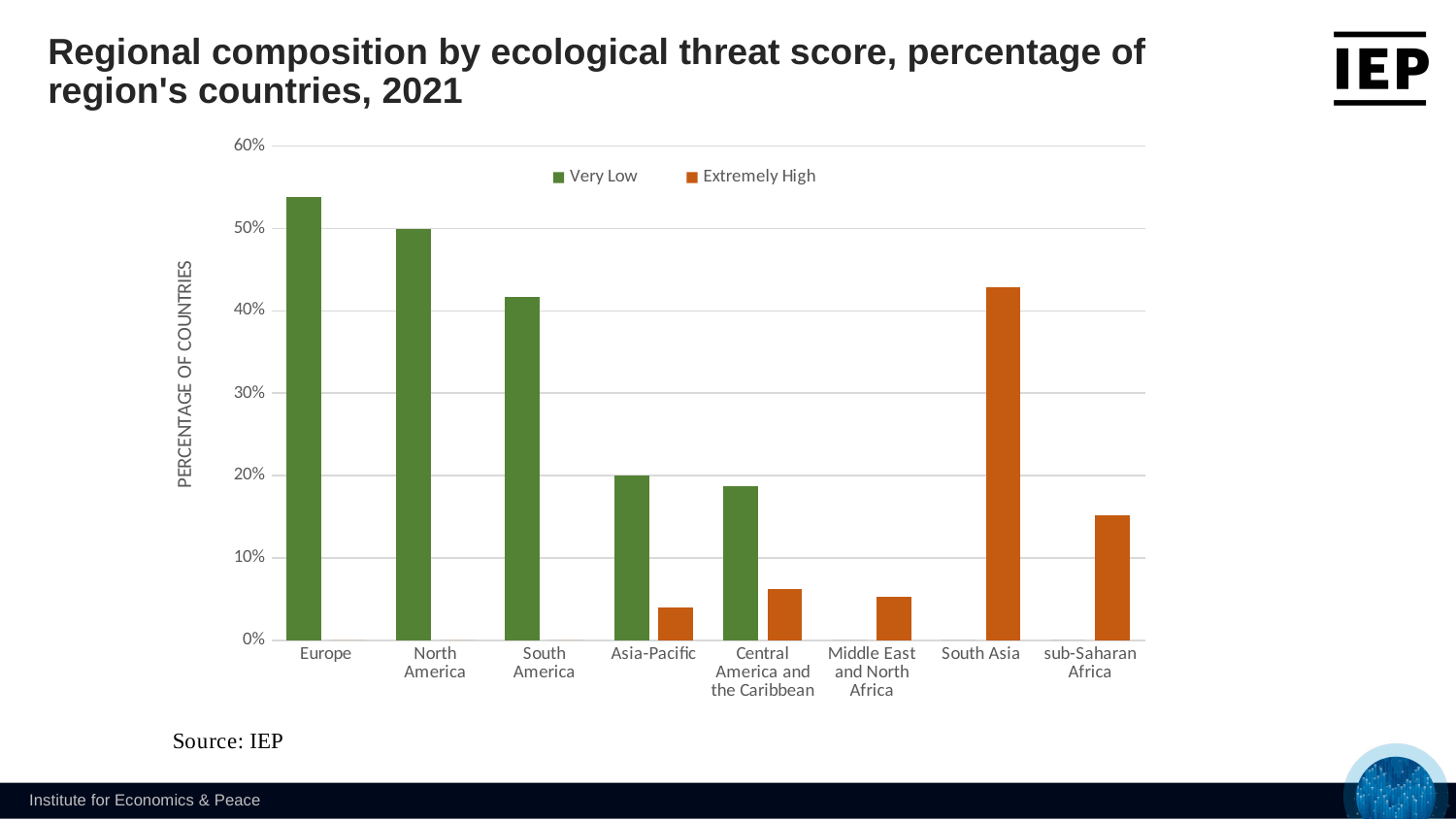
Which is larger: the Extremely High value for Asia-Pacific or the Extremely High value for Central America and the Caribbean? Central America and the Caribbean Is the Very Low value for South America greater or less than 40%? greater Is the Extremely High value for sub-Saharan Africa greater or less than 20%? less Which region has the highest Extremely High value? South Asia Is the Extremely High value for South Asia greater or less than 40%? greater How many series does the legend list? 2 What kind of chart is shown on the slide? bar chart How many regions are shown on the x axis? 8 Which region has the highest Very Low value? Europe What is the title of the y axis? PERCENTAGE OF COUNTRIES Which is larger: the Very Low value for Europe or the Extremely High value for South Asia? Very Low value for Europe